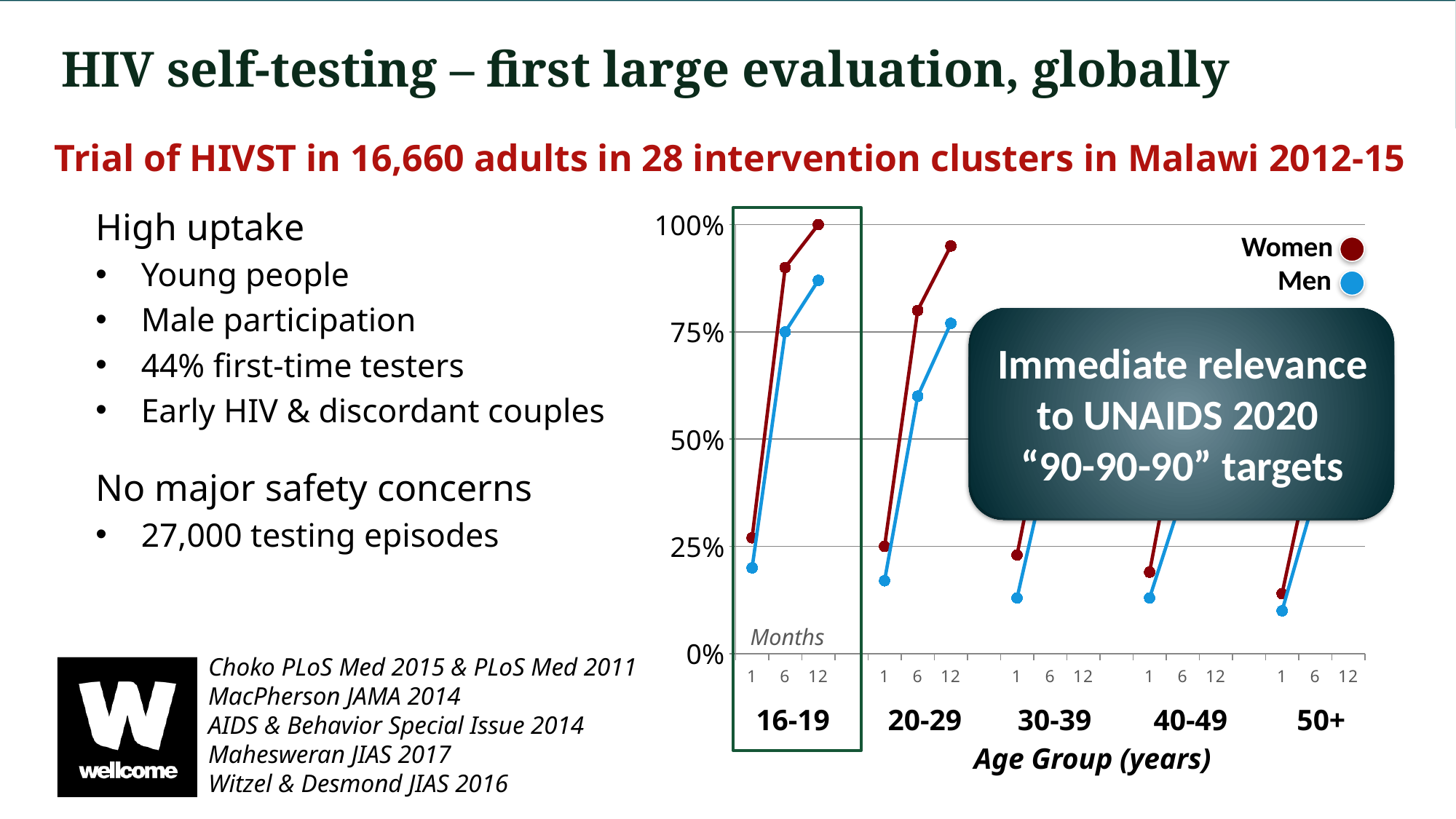
Which series is shown in blue in the chart? Men Is the value for Men in the 16-19 age group at 12 months greater or less than 75%? greater In the 16-19 age group, do the values for Women rise or fall from 1 month to 12 months? rise How many series does the chart legend list? 2 In the 16-19 age group at 12 months, which series has the higher value, Women or Men? Women How many age groups are shown along the x axis of the chart? 5 What kind of chart is shown on the slide? line chart What is the x-axis title of the chart? Age Group (years) Is the value for Men in the 16-19 age group at 1 month greater or less than 25%? less Is the value for Women in the 16-19 age group at 12 months greater or less than 75%? greater